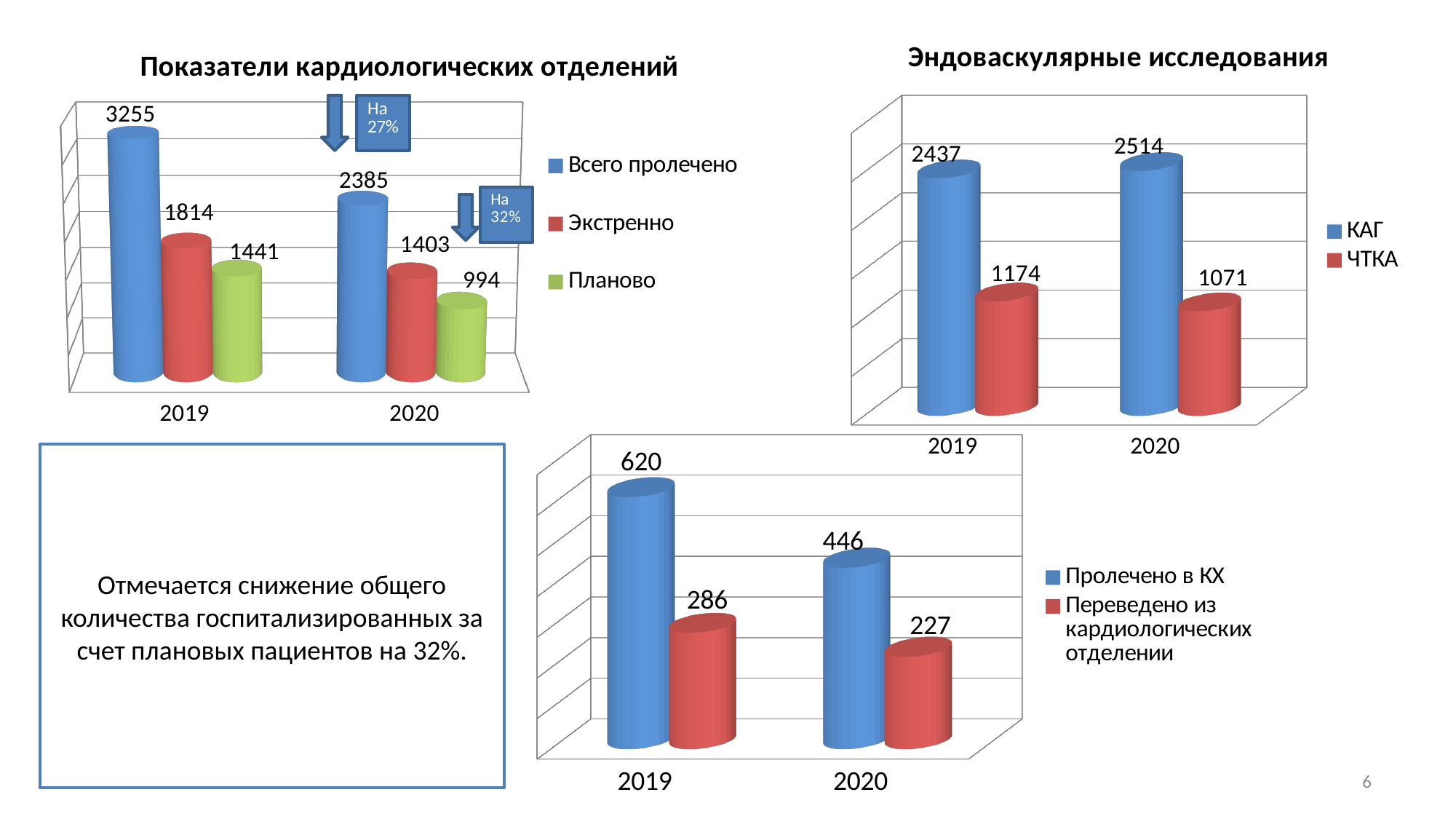
In the chart 'Показатели кардиологических отделений', how many series does the legend list? 3 In the chart 'Показатели кардиологических отделений', what is the value of 'Планово' for 2020? 994 In the chart 'Эндоваскулярные исследования', which is larger: 'КАГ' in 2019 or 'КАГ' in 2020? КАГ in 2020 In the chart 'Показатели кардиологических отделений', does 'Всего пролечено' rise or fall from 2019 to 2020? fall What type of chart is the bottom chart with legend 'Пролечено в КХ'? bar chart In the bottom chart with legend 'Пролечено в КХ', what is the value of 'Переведено из кардиологических отделении' for 2020? 227 In the chart 'Эндоваскулярные исследования', what is the value of 'ЧТКА' for 2019? 1174 In the chart 'Показатели кардиологических отделений', what is the value of 'Всего пролечено' for 2019? 3255 In the chart 'Эндоваскулярные исследования', what is the value of 'КАГ' for 2020? 2514 In the chart 'Показатели кардиологических отделений', by how much did 'Экстренно' change from 2019 to 2020? 411 In the chart 'Эндоваскулярные исследования', what is the difference between 'КАГ' and 'ЧТКА' in 2020? 1443 In the bottom chart with legend 'Пролечено в КХ', what is the value of 'Пролечено в КХ' for 2019? 620